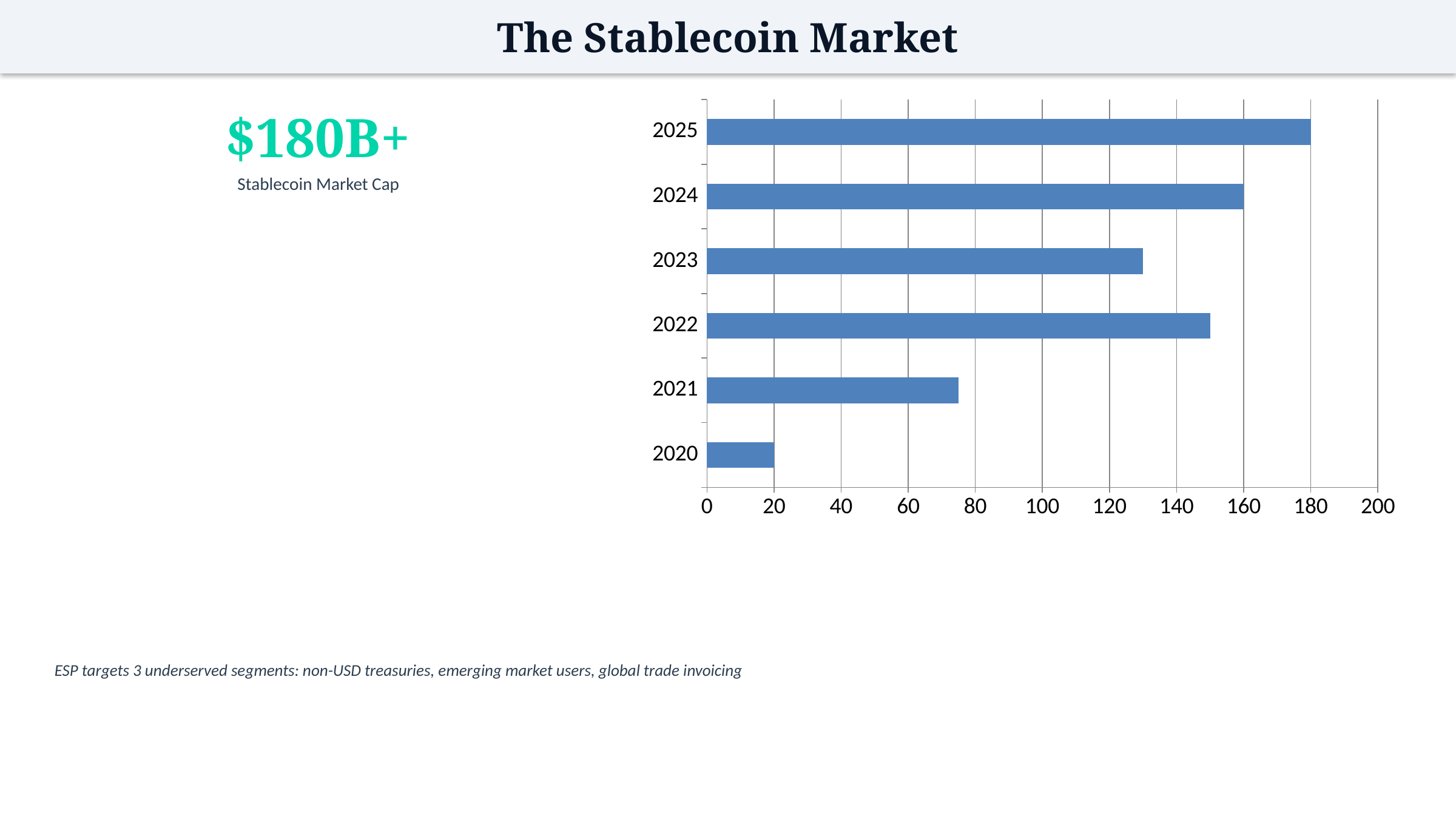
Is the value for 2023 greater or less than 140? less Is the value for 2022 greater or less than 140? greater Which year has the larger value, 2022 or 2023? 2022 What is the value for 2024 in the bar chart? 160 What figure is shown in large text to the left of the chart as the Stablecoin Market Cap? $180B+ What type of chart is shown on the slide? bar chart What is the value for 2025 in the bar chart? 180 What is the value for 2020 in the bar chart? 20 What is the difference between the values for 2025 and 2024? 20 How many years are plotted in the bar chart? 6 Which year has the highest value in the bar chart? 2025 Which year has the lowest value in the bar chart? 2020